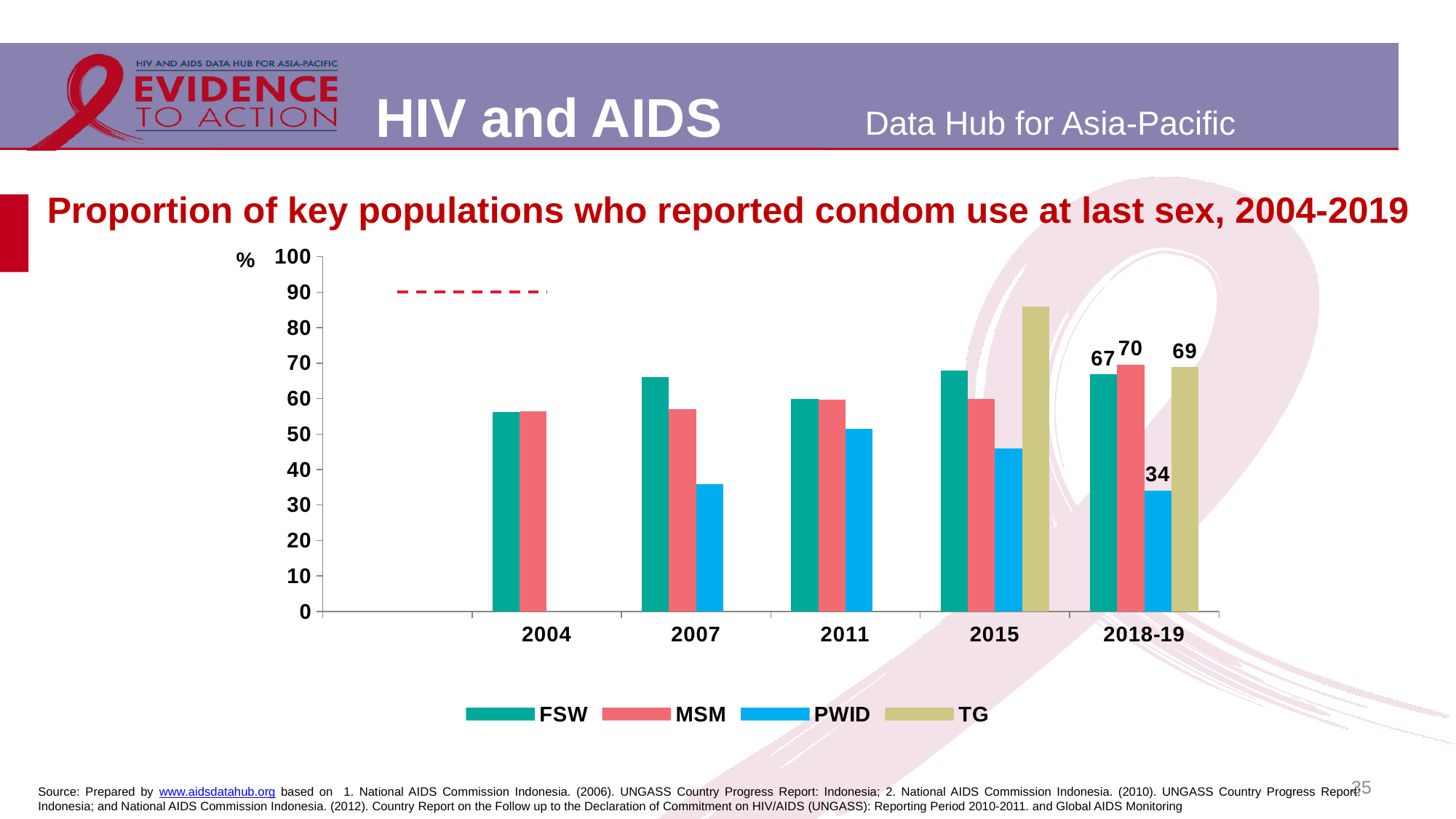
How many time periods are shown on the x axis? 5 Is the value for TG in 2015 greater or less than 80? greater Is the value for PWID in 2007 greater or less than 40? less Does the value for PWID rise or fall from 2015 to 2018-19? fall What is the value for PWID in 2018-19? 34 What is the value for TG in 2018-19? 69 Which key population has the lowest value in 2018-19? PWID In 2015, which is larger: the value for TG or the value for FSW? TG What is the difference between the MSM and PWID values in 2018-19? 36 Which key population has the highest value in 2018-19? MSM How many series does the legend list? 4 What is the value for MSM in 2018-19? 70